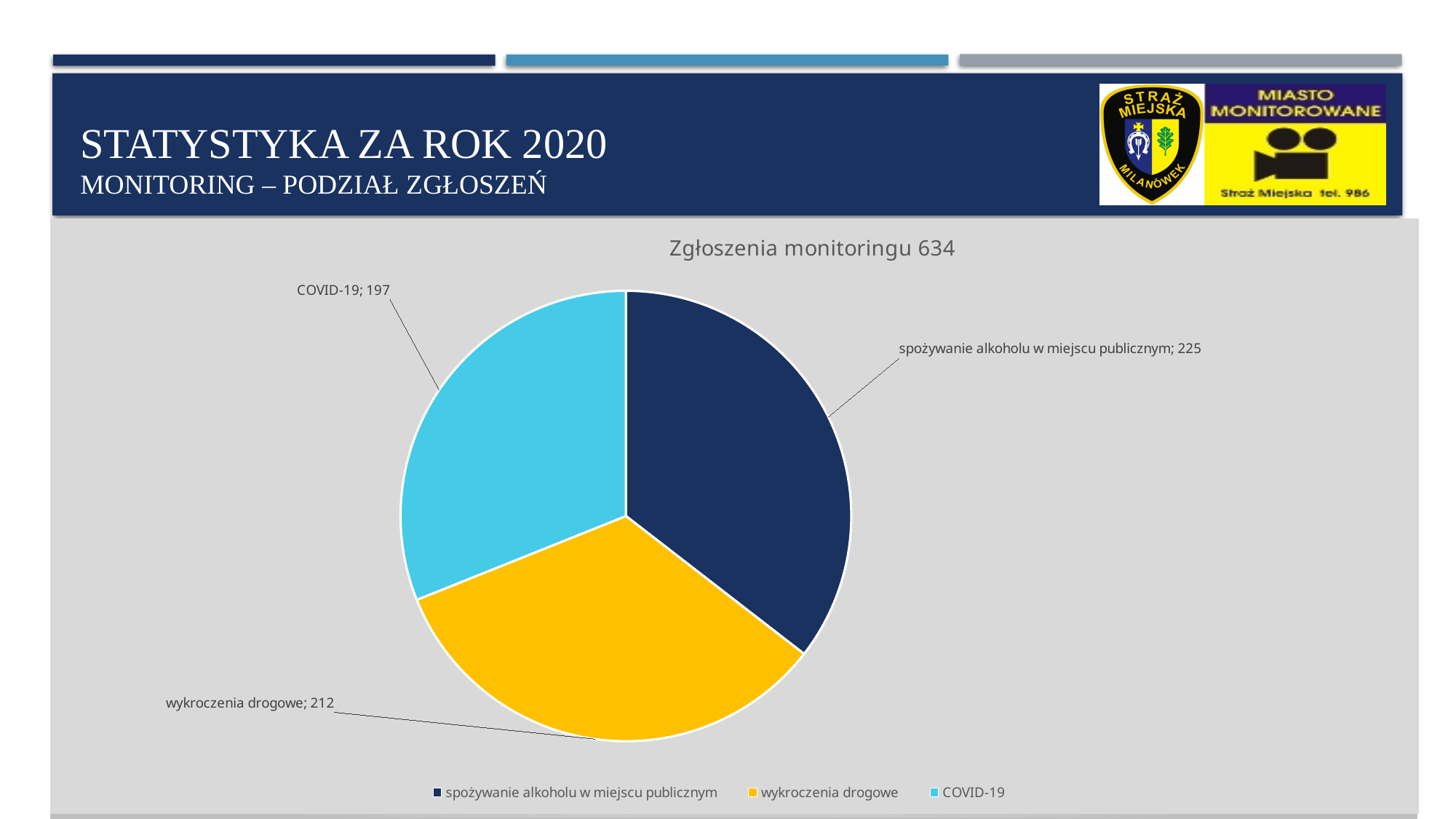
What is the value for spożywanie alkoholu w miejscu publicznym? 225 How many slices does the pie chart have? 3 What is the value for COVID-19? 197 How many entries does the legend list? 3 What kind of chart is shown on the slide? pie chart Which category has the highest value? spożywanie alkoholu w miejscu publicznym Which category has the lowest value? COVID-19 What is the value for wykroczenia drogowe? 212 Which is larger, the value for wykroczenia drogowe or the value for COVID-19? wykroczenia drogowe What is the difference between the values for spożywanie alkoholu w miejscu publicznym and COVID-19? 28 What share of the total does the spożywanie alkoholu w miejscu publicznym slice represent? 35.5% What is the title of the chart? Zgłoszenia monitoringu 634